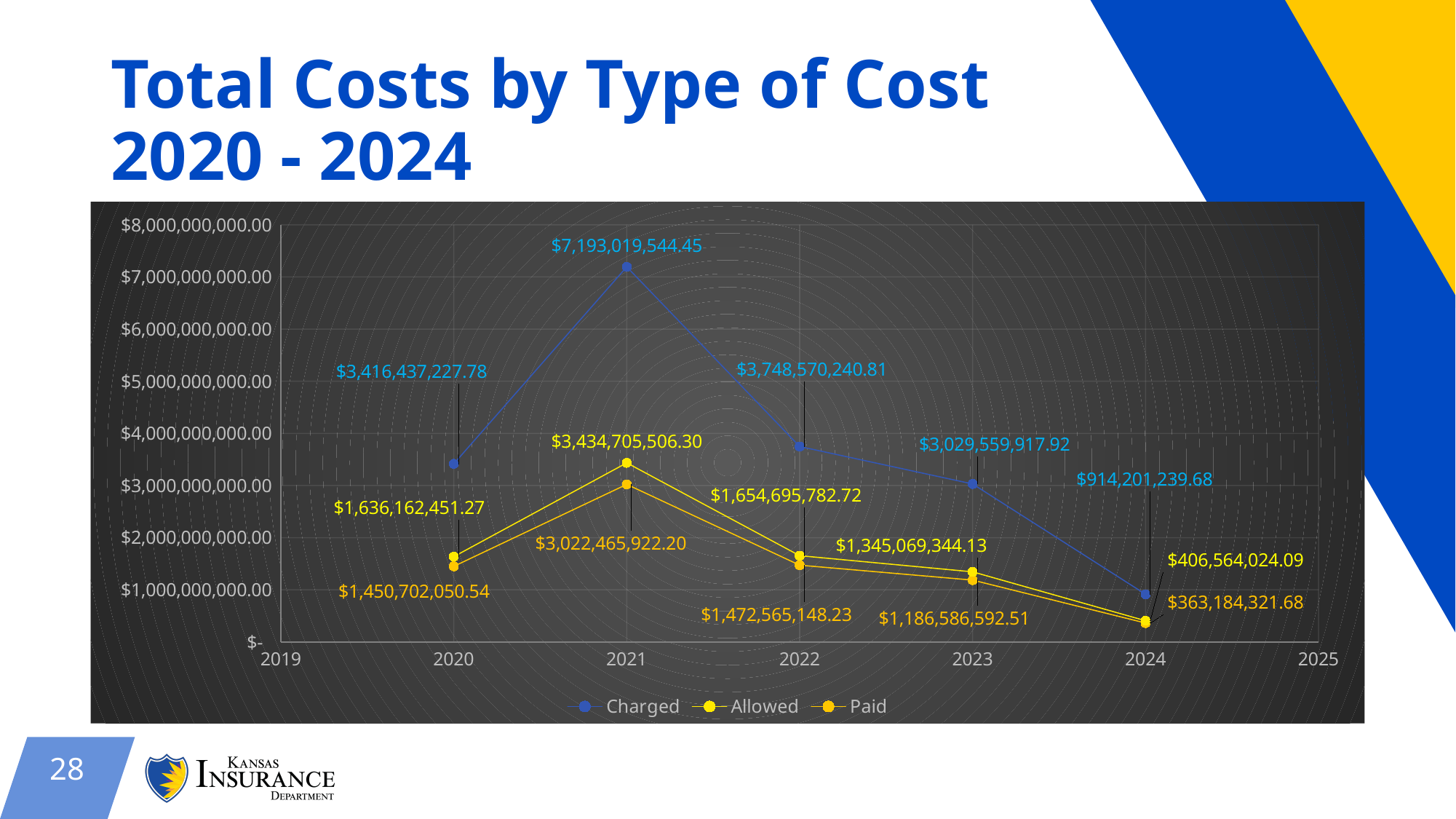
What was the Charged value in 2021? $7,193,019,544.45 Which was larger in 2022, the Charged value or the Allowed value? Charged What was the Allowed value in 2024? $406,564,024.09 How did the Charged value change from 2021 to 2024? It fell What is the difference between the Charged values in 2021 and 2020? $3,776,582,316.67 How many series does the legend list? 3 In which year was the Paid value lowest? 2024 What was the Paid value in 2023? $1,186,586,592.51 In which year was the Charged value highest? 2021 What is the difference between the Allowed and Paid values in 2024? $43,379,702.41 What type of chart is shown on the slide? Line chart How many years have data points plotted for each series? 5